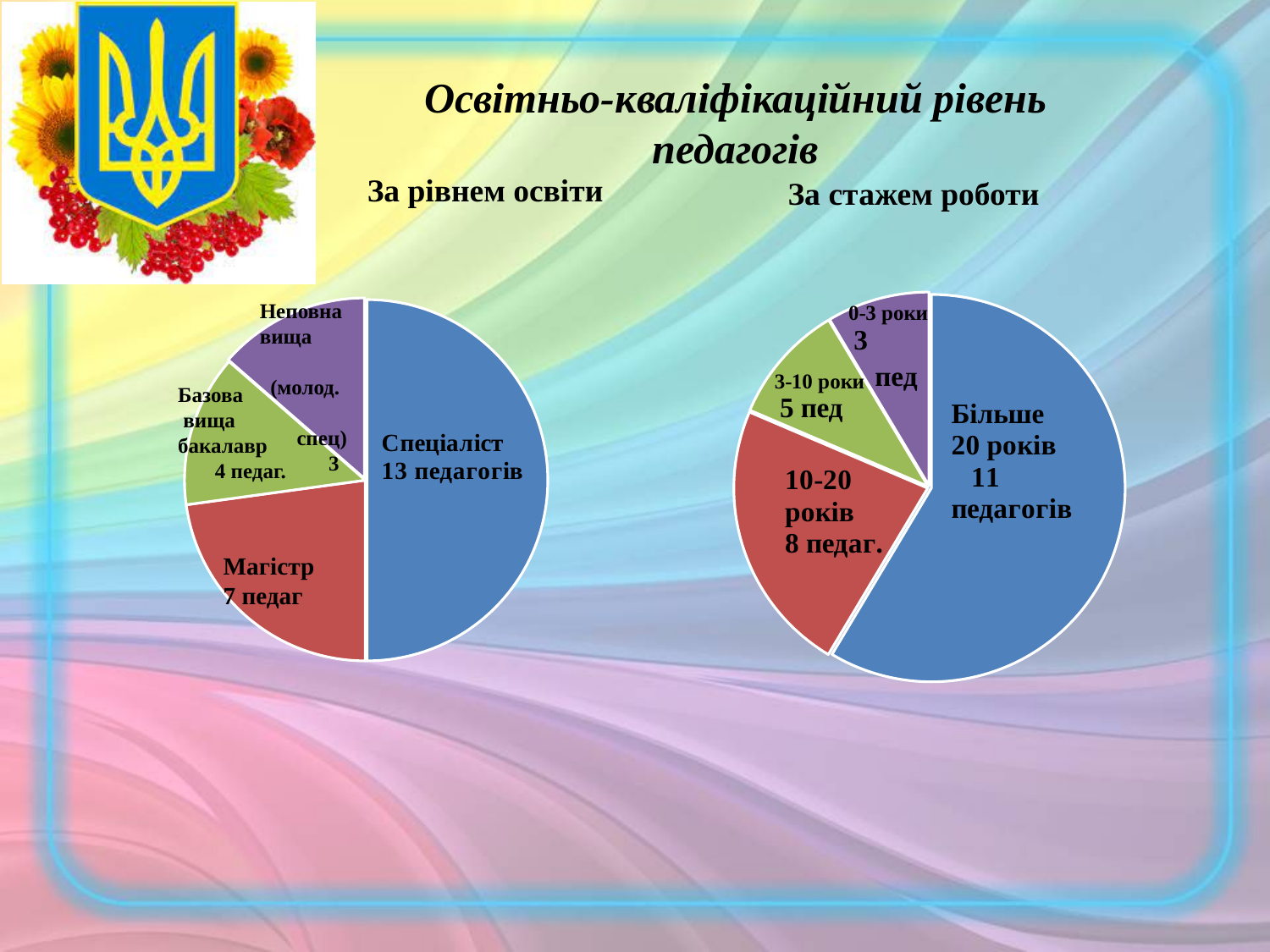
In the 'За стажем роботи' chart, which category has the smallest slice? 0-3 роки In the 'За стажем роботи' chart, how many teachers have more than 20 years of experience ('Більше 20 років')? 11 In the 'За стажем роботи' chart, what is the total number of teachers across all slices? 27 In the 'За рівнем освіти' chart, what is the difference between the number of 'Спеціаліст' teachers and 'Магістр' teachers? 6 In the 'За рівнем освіти' chart, which category has the smallest slice? Неповна вища (молод. спец) How many categories does the 'За рівнем освіти' pie chart have? 4 In the 'За рівнем освіти' chart, how many teachers are in the 'Спеціаліст' category? 13 In the 'За рівнем освіти' chart, which category has the largest slice? Спеціаліст In the 'За рівнем освіти' chart, how many teachers are in the 'Магістр' category? 7 What type of chart is used for 'За стажем роботи'? Pie chart In the 'За стажем роботи' chart, which is larger: '3-10 роки' or '10-20 років'? 10-20 років In the 'За стажем роботи' chart, how many teachers are in the '10-20 років' category? 8